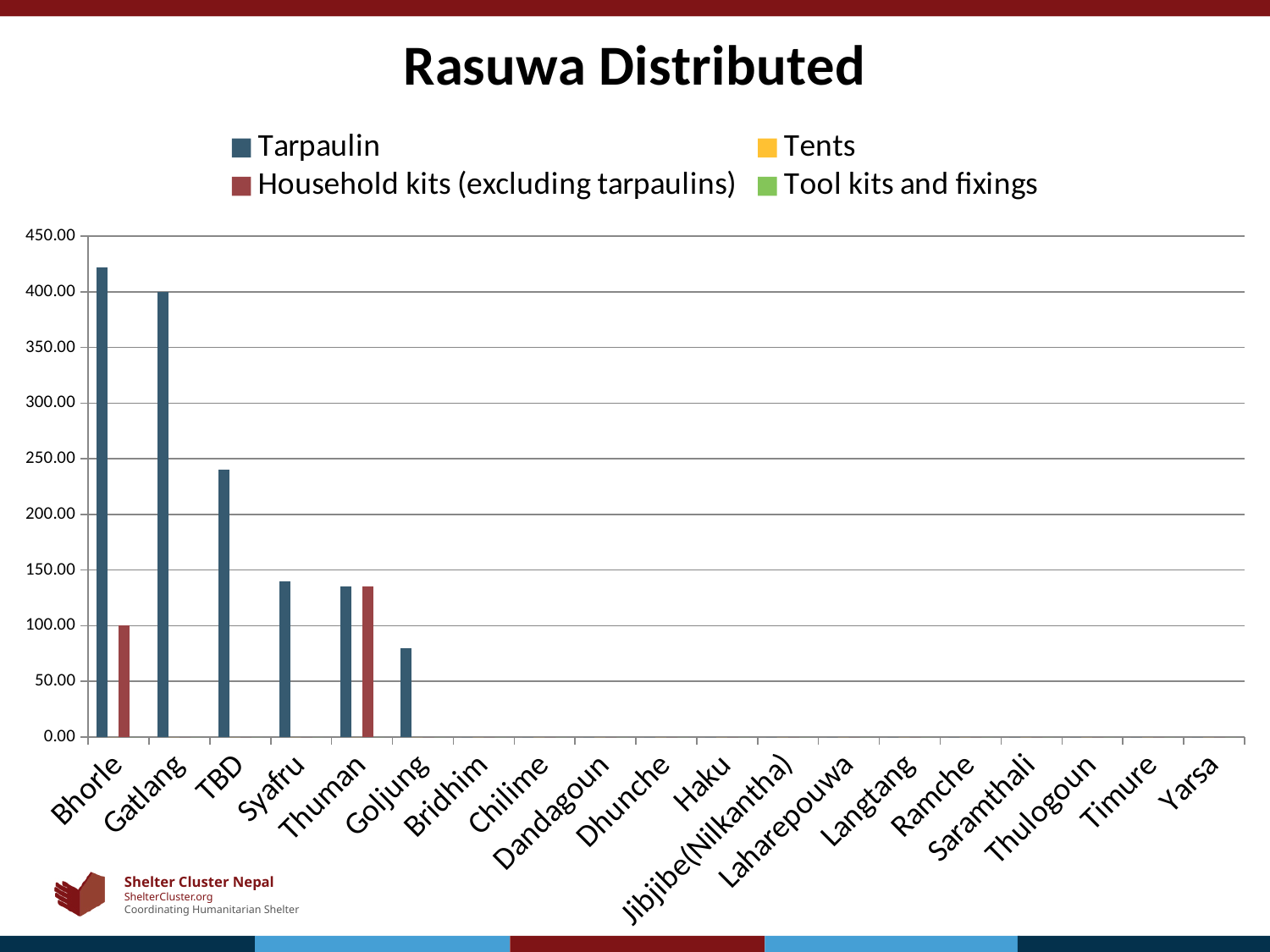
Which has the larger Tarpaulin value, Gatlang or TBD? Gatlang What is the title of the chart? Rasuwa Distributed How many series does the legend list? 4 Is the Tarpaulin value for Bhorle greater or less than 400? greater What is the Tarpaulin value for Gatlang? 400.00 How many categories are shown on the x axis? 19 Which legend entry is shown in red? Household kits (excluding tarpaulins) Is the Tarpaulin value for Goljung greater or less than 100? less What is the Household kits (excluding tarpaulins) value for Bhorle? 100.00 Is the Tarpaulin value for TBD greater or less than 250? less What kind of chart is shown on the slide? Bar chart Which category has the highest Tarpaulin value? Bhorle